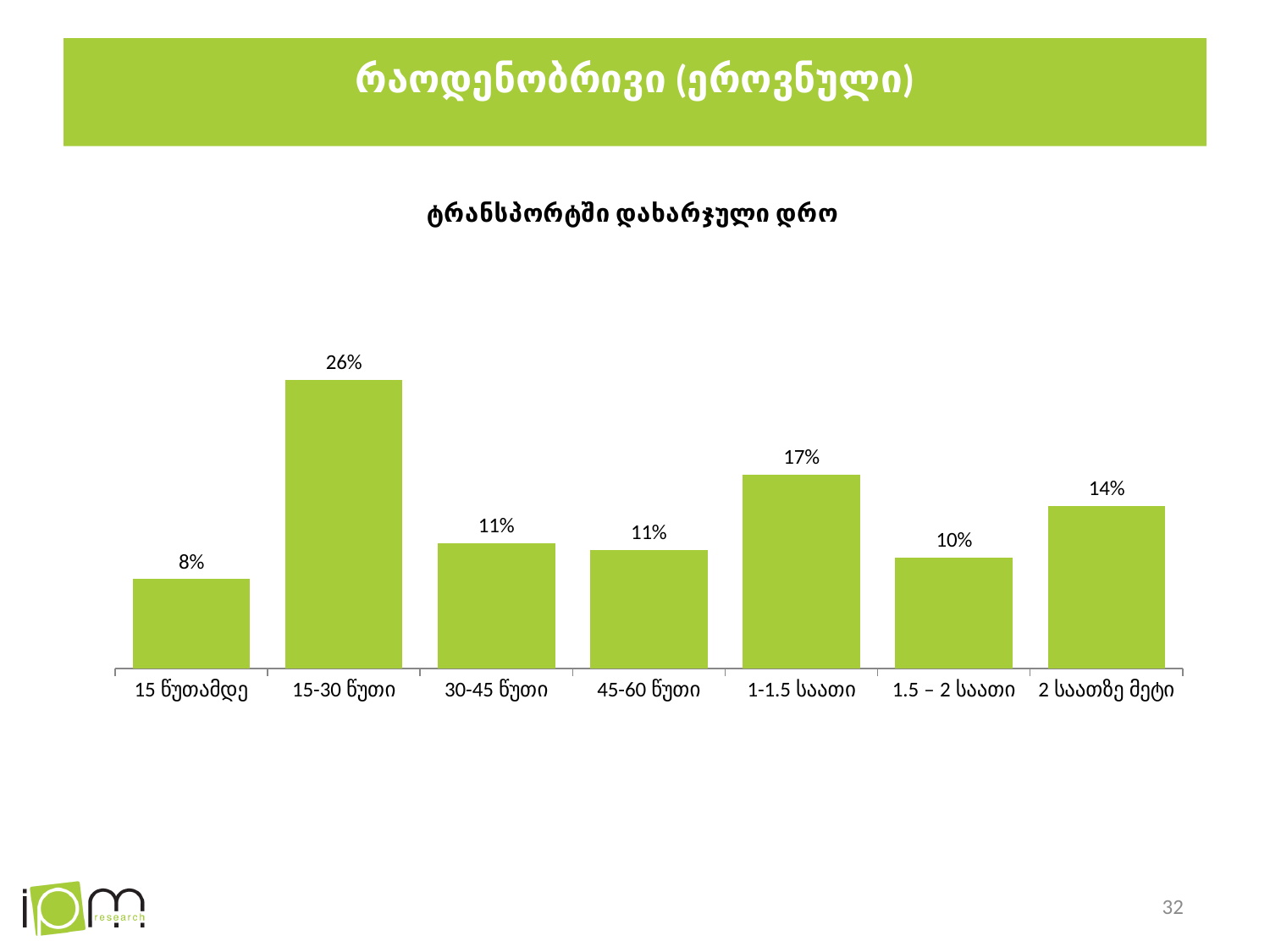
What kind of chart is shown on the slide? Bar chart What is the value for the "2 საათზე მეტი" category? 14% Which is larger, the value for "1-1.5 საათი" or the value for "2 საათზე მეტი"? 1-1.5 საათი Which category has the lowest value? 15 წუთამდე What is the title of the chart? ტრანსპორტში დახარჯული დრო What is the value for the "15-30 წუთი" category? 26% Which category has the highest value? 15-30 წუთი How many categories are shown on the x axis of the chart? 7 What is the difference between the values for "15-30 წუთი" and "1-1.5 საათი"? 9% What colour are the bars in the chart? Green What is the value for the "1-1.5 საათი" category? 17% What is the difference between the values for "2 საათზე მეტი" and "1.5 – 2 საათი"? 4%